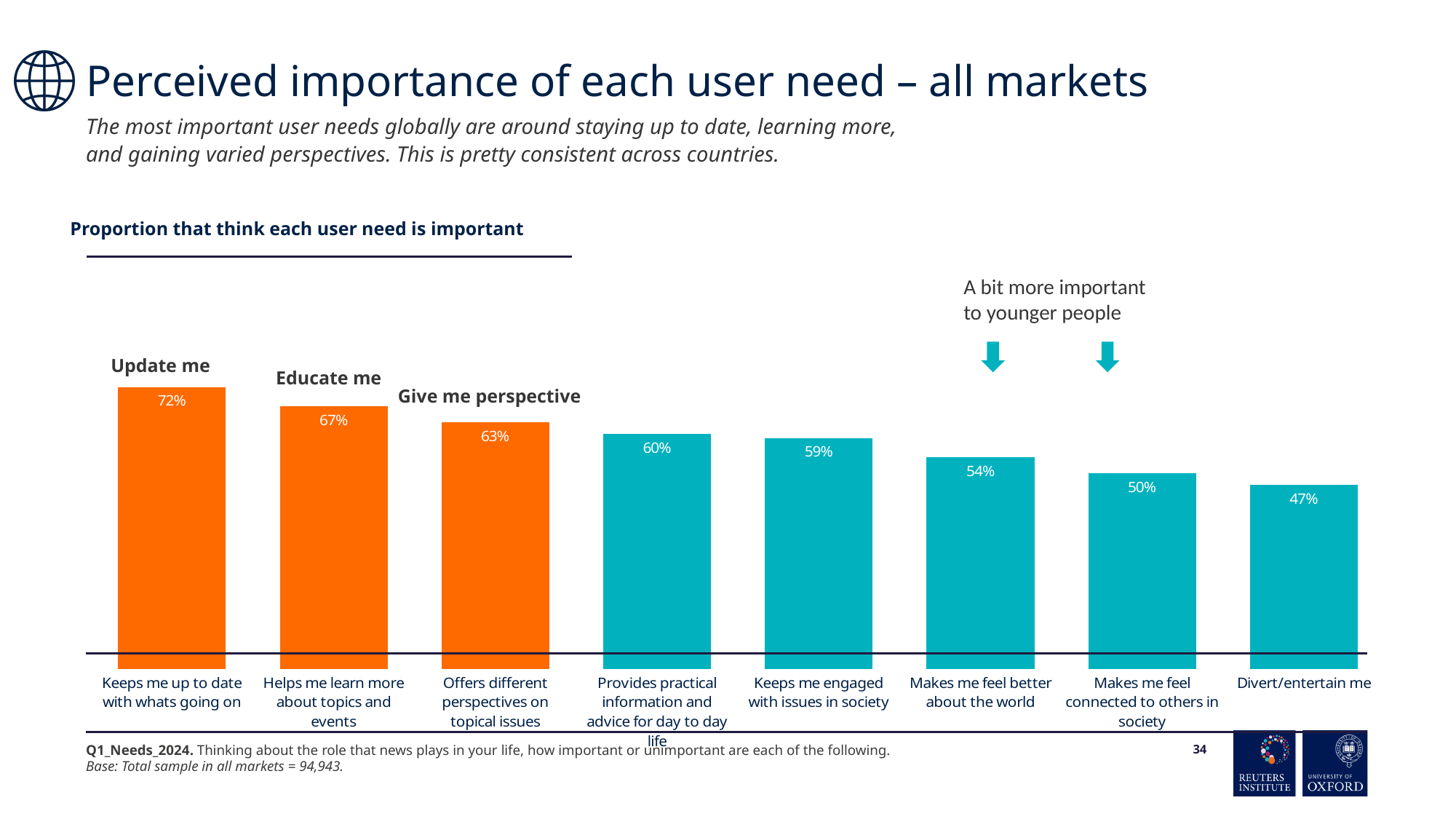
What proportion think 'Keeps me up to date with whats going on' is important? 72% What is the value for 'Divert/entertain me'? 47% What is the difference between 'Helps me learn more about topics and events' and 'Makes me feel connected to others in society'? 17% Which user need has the lowest proportion rating it important? Divert/entertain me What is the chart's title? Proportion that think each user need is important Do the values rise or fall from left to right across the chart? Fall Which bars are coloured orange rather than teal? The first three (Update me, Educate me, Give me perspective) What is the value for 'Makes me feel better about the world'? 54% How many user needs are shown in the chart? 8 What kind of chart is shown on the slide? Bar chart Which user need has the highest proportion rating it important? Keeps me up to date with whats going on Which is larger: 'Provides practical information and advice for day to day life' or 'Keeps me engaged with issues in society'? Provides practical information and advice for day to day life